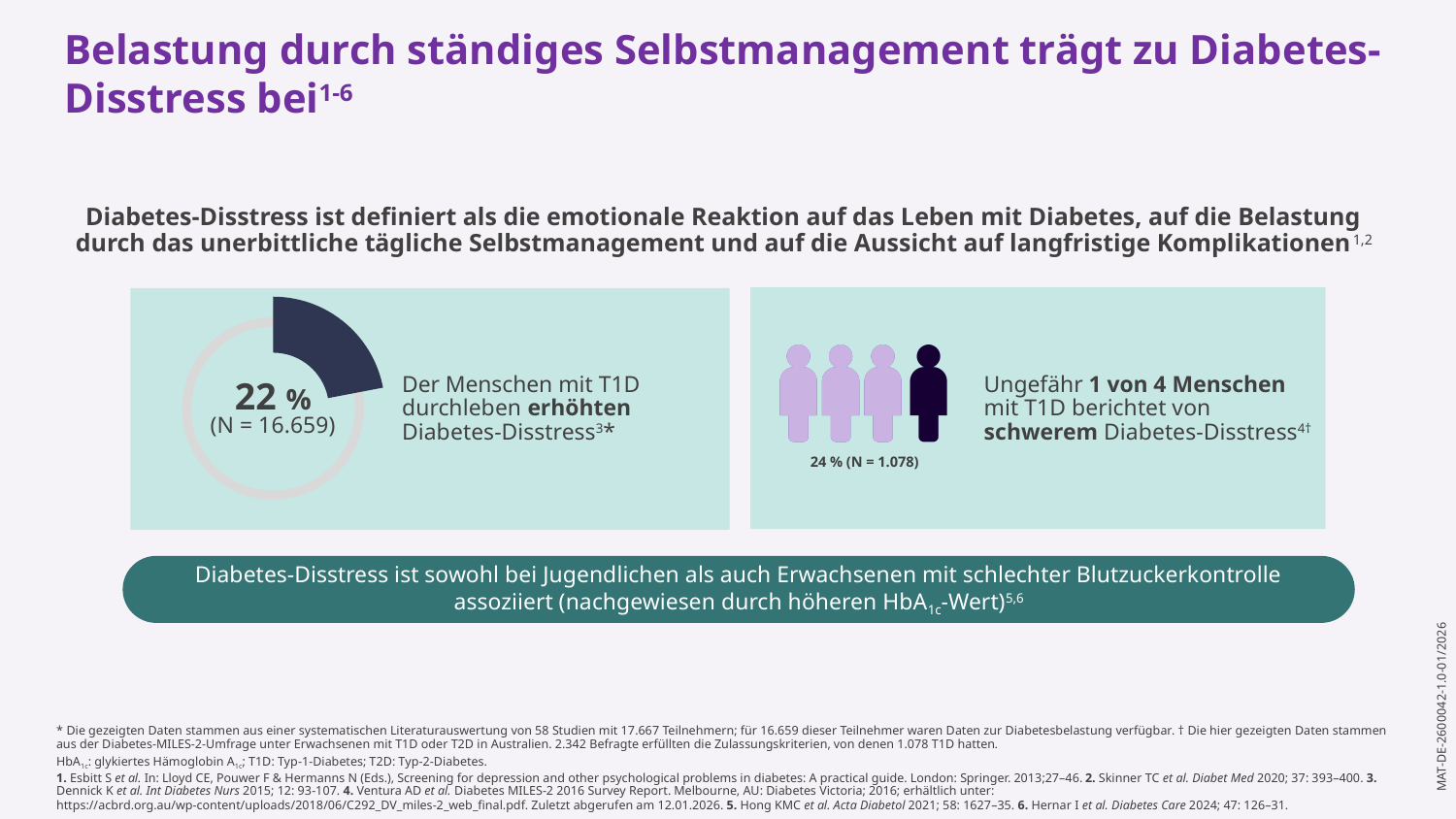
In the right chart, how many of the person icons are highlighted in dark colour? 1 In the left chart (donut), what sample size (N) is shown in the centre? N = 16.659 In the right chart (person icons), what percentage of people with T1D report severe diabetes distress? 24 % Which value is larger: the 22 % in the left chart or the 24 % in the right chart? 24 % (right chart) In the left chart, what colour is the highlighted 22 % segment of the donut? Dark navy/purple In the right chart, what ratio of people with T1D does the highlighted icon represent according to the text beside it? 1 von 4 What kind of chart is shown on the left side of the slide? Donut (pie) chart In the right chart, how many person icons are shown in total? 4 What is the difference in percentage points between the right chart's 24 % and the left chart's 22 %? 2 percentage points In the left chart (donut), what percentage of people with T1D experience elevated diabetes distress? 22 % In the left chart, is the highlighted share greater or less than 25 %? less In the right chart (person icons), what sample size (N) is given below the icons? N = 1.078